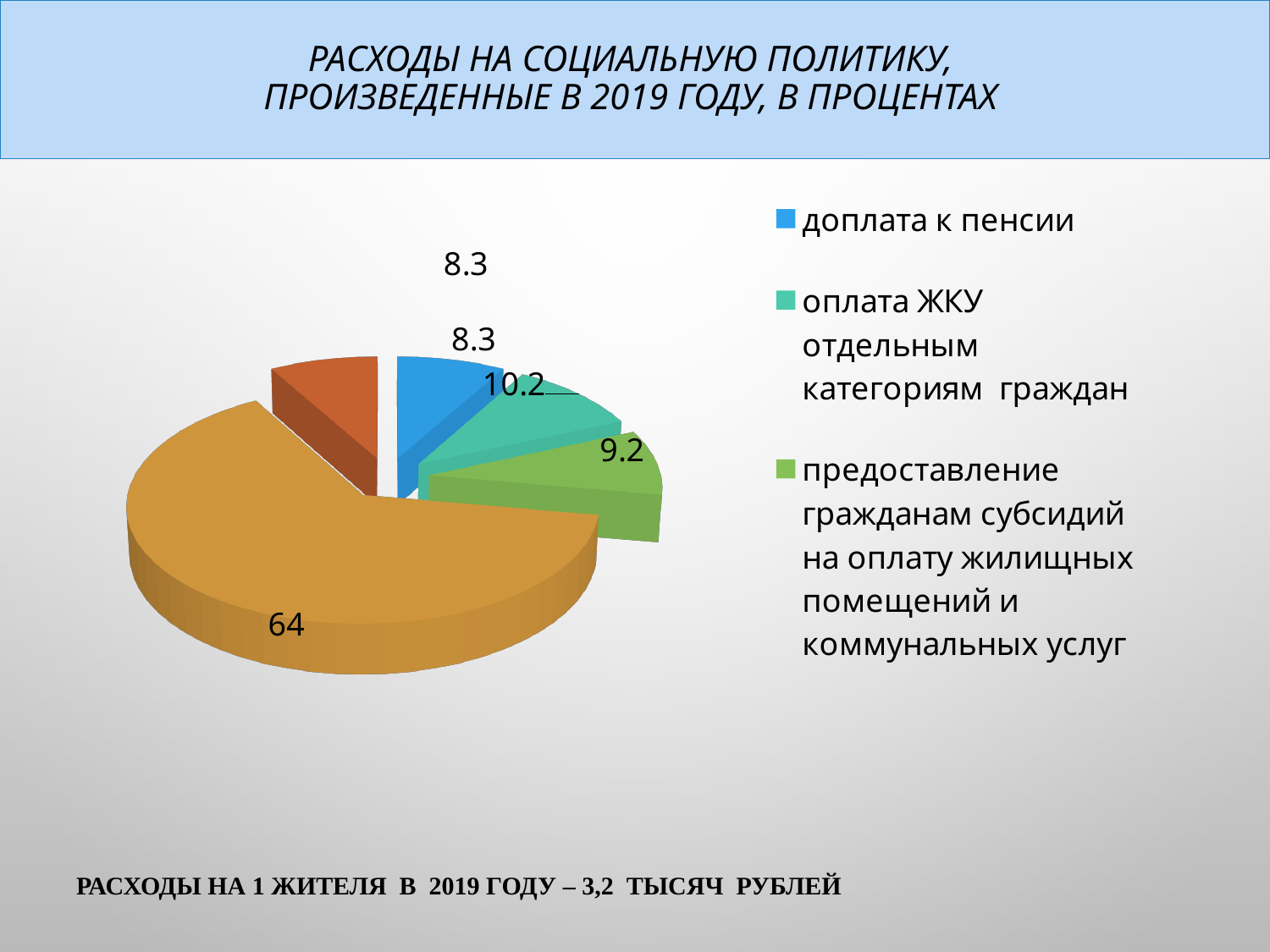
How many slices does the pie chart have? 5 What is the difference between the value for оплата ЖКУ отдельным категориям граждан and the value for доплата к пенсии? 1.9 What is the value for оплата ЖКУ отдельным категориям граждан? 10.2 What type of chart is shown on the slide? pie chart What is the value of the largest slice in the pie chart? 64 What is the difference between the value for оплата ЖКУ отдельным категориям граждан and the value for предоставление гражданам субсидий? 1 What is the value for предоставление гражданам субсидий на оплату жилищных помещений и коммунальных услуг? 9.2 What is the smallest value labelled on the pie chart? 8.3 What colour is the slice for доплата к пенсии? blue Which is larger: оплата ЖКУ отдельным категориям граждан or предоставление гражданам субсидий? оплата ЖКУ отдельным категориям граждан What is the value for доплата к пенсии? 8.3 How many entries does the legend list? 3